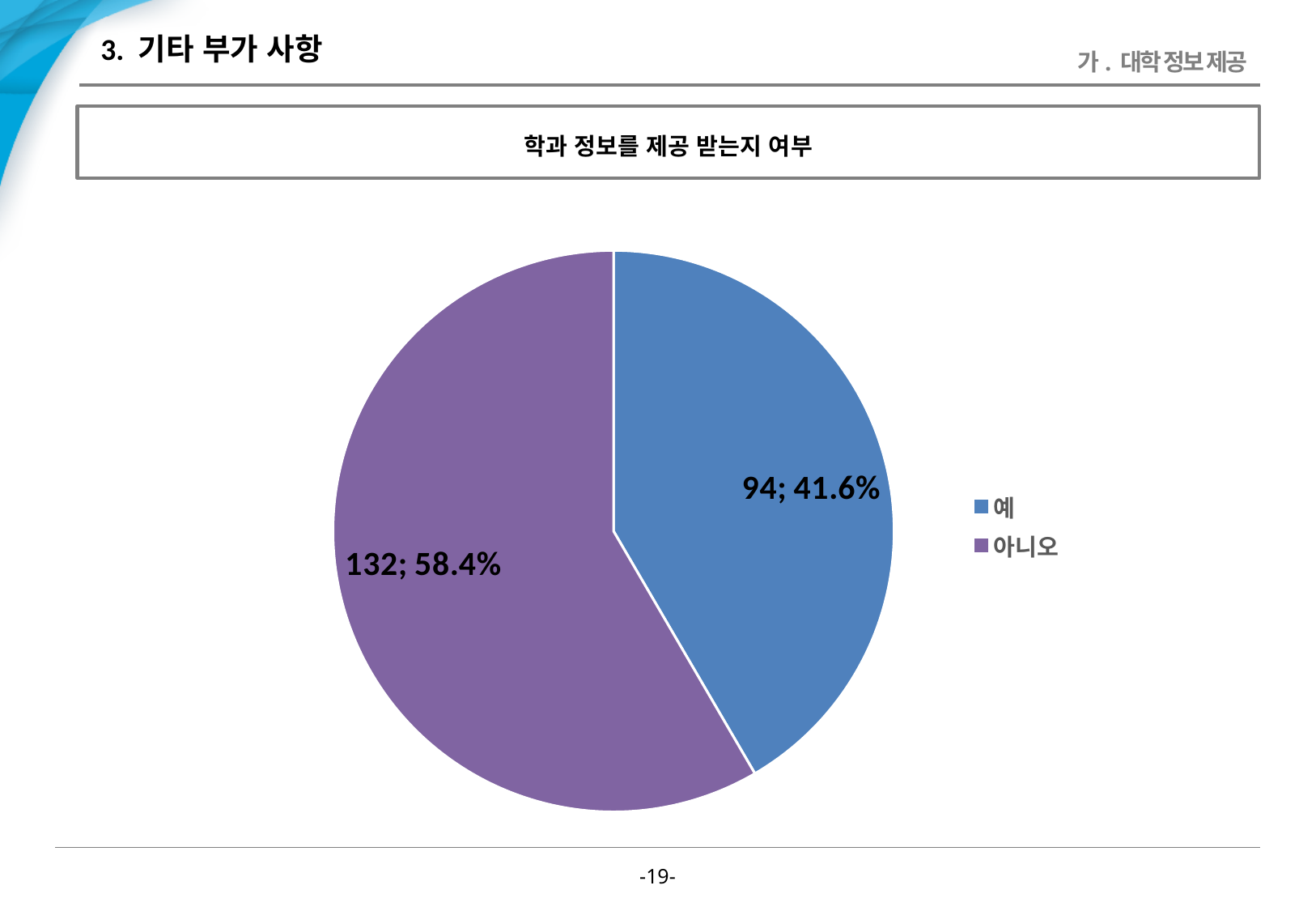
What colour is the slice for 아니오? purple What is the count for 아니오 (No)? 132 What share of the pie does 예 (Yes) represent? 41.6% Which category has the largest slice? 아니오 How many entries does the legend list? 2 What is the count for 예 (Yes)? 94 What is the difference in count between 아니오 and 예? 38 How many slices does the pie chart have? 2 What kind of chart is shown on the slide? pie chart Which category has the smallest slice? 예 What is the total count across both slices? 226 What share of the pie does 아니오 (No) represent? 58.4%